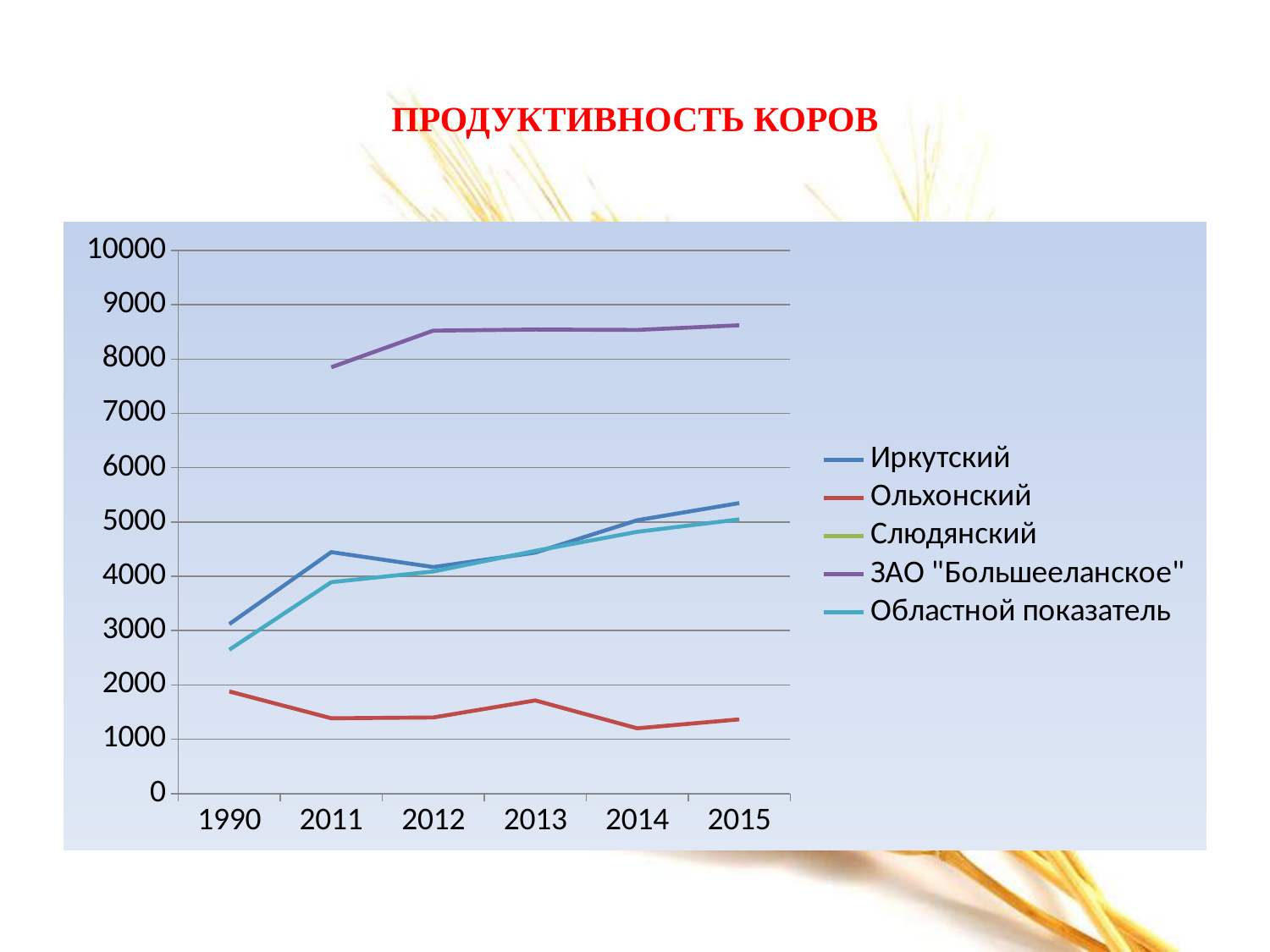
What kind of chart is shown on the slide? line chart Is the value for Ольхонский in 2015 greater or less than 2000? less Does the Ольхонский line rise or fall from 1990 to 2011? falls In 2011, which is higher: Иркутский or Областной показатель? Иркутский How many years are shown on the x axis? 6 Is the value for ЗАО "Большееланское" in 2015 greater or less than 8000? greater How many series does the legend list? 5 Which series has the lowest value in 2015? Ольхонский Is the value for Областной показатель in 1990 greater or less than 3000? less Does the Областной показатель line rise or fall from 1990 to 2015? rises What is the title of the slide's chart? ПРОДУКТИВНОСТЬ КОРОВ Which series has the highest value in 2015? ЗАО "Большееланское"